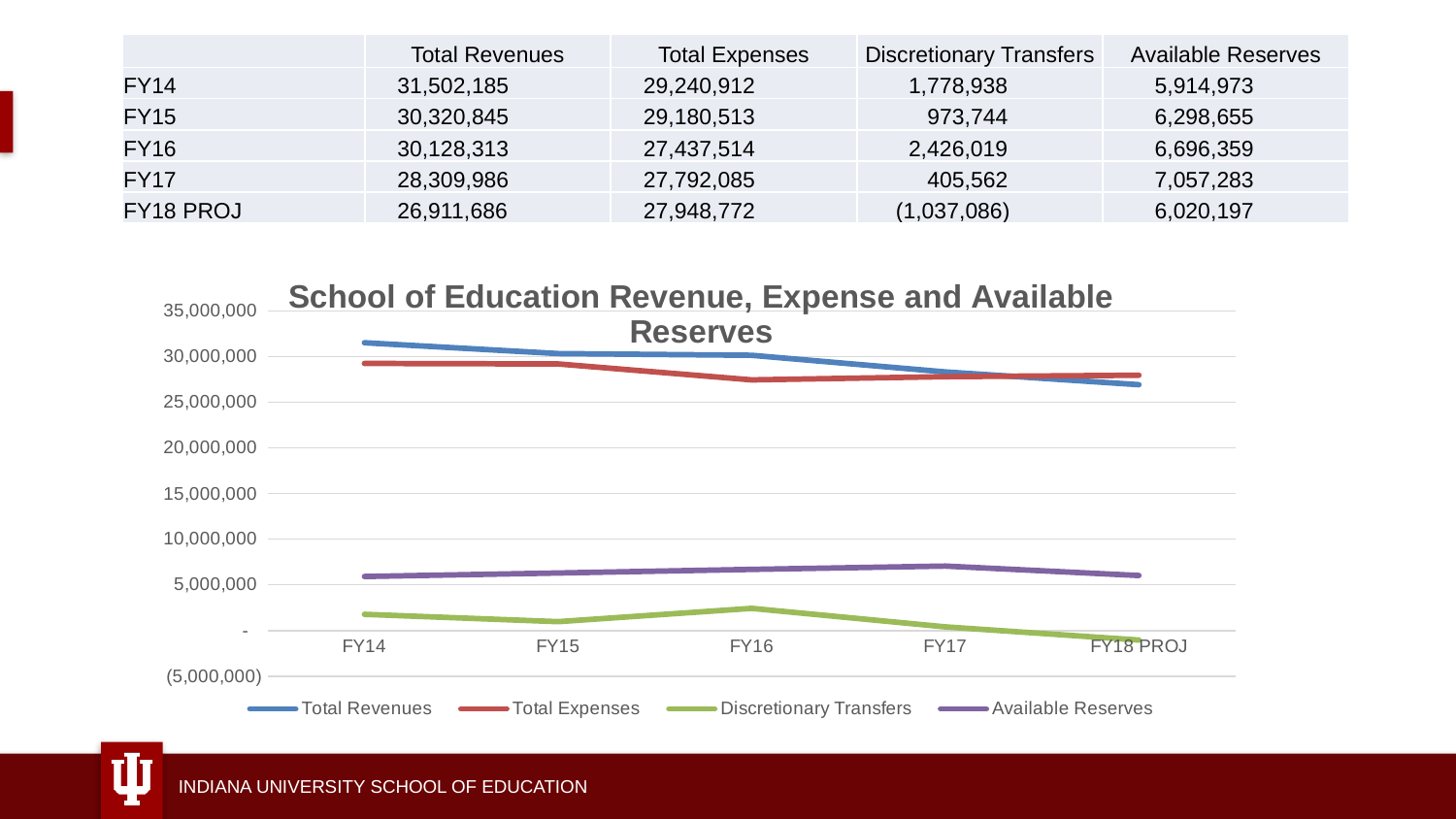
What is the value of Available Reserves for FY17? 7,057,283 How many series does the chart legend list? 4 Is the value of Total Expenses for FY16 greater or less than 30,000,000? less What is the value of Total Revenues for FY14? 31,502,185 How many fiscal years are plotted along the x axis of the chart? 5 Which is larger for FY18 PROJ, Total Revenues or Total Expenses? Total Expenses What is the title of the chart? School of Education Revenue, Expense and Available Reserves Which fiscal year has the highest Total Revenues? FY14 Which fiscal year has the lowest Discretionary Transfers? FY18 PROJ What kind of chart is shown on the slide? line chart Do Total Revenues rise or fall from FY14 to FY18 PROJ? fall What is the value of Discretionary Transfers for FY18 PROJ? (1,037,086)